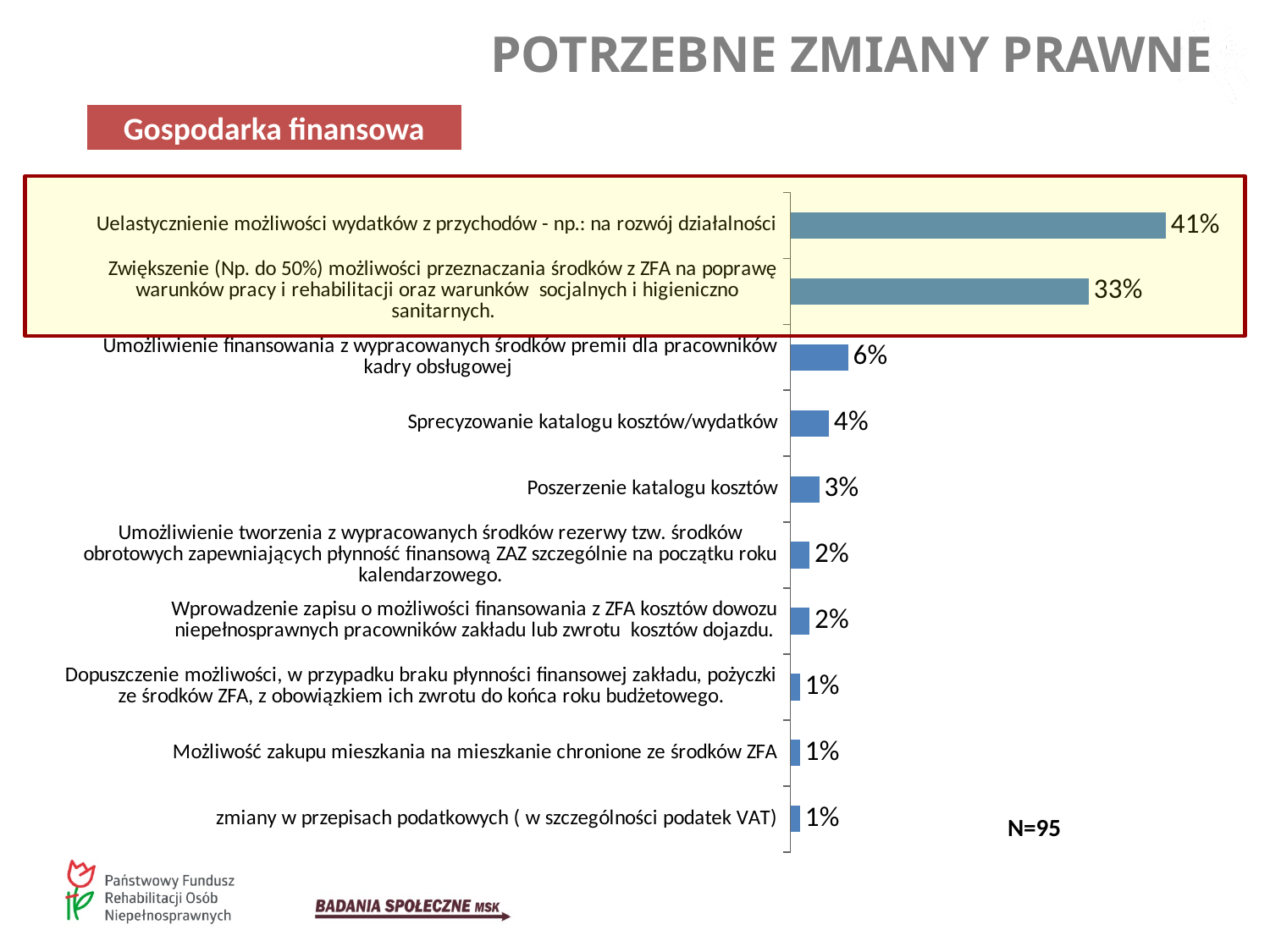
What percentage is shown for "Poszerzenie katalogu kosztów"? 3% What value is shown for "Sprecyzowanie katalogu kosztów/wydatków"? 4% What percentage is shown for "Uelastycznienie możliwości wydatków z przychodów - np.: na rozwój działalności"? 41% How many categories are shown in the chart? 10 What type of chart is shown on the slide? Bar chart Which category has the highest value in the chart? Uelastycznienie możliwości wydatków z przychodów - np.: na rozwój działalności Which has a larger value: "Umożliwienie finansowania z wypracowanych środków premii dla pracowników kadry obsługowej" or "Sprecyzowanie katalogu kosztów/wydatków"? Umożliwienie finansowania z wypracowanych środków premii dla pracowników kadry obsługowej What is the difference between the values for "Uelastycznienie możliwości wydatków z przychodów" and "Zwiększenie (Np. do 50%) możliwości przeznaczania środków z ZFA"? 8% What is the sample size (N) shown next to the chart? N=95 What is the difference between the values for "Sprecyzowanie katalogu kosztów/wydatków" and "Poszerzenie katalogu kosztów"? 1% What value is shown for "Umożliwienie finansowania z wypracowanych środków premii dla pracowników kadry obsługowej"? 6% What is the heading in the red box above the chart? Gospodarka finansowa